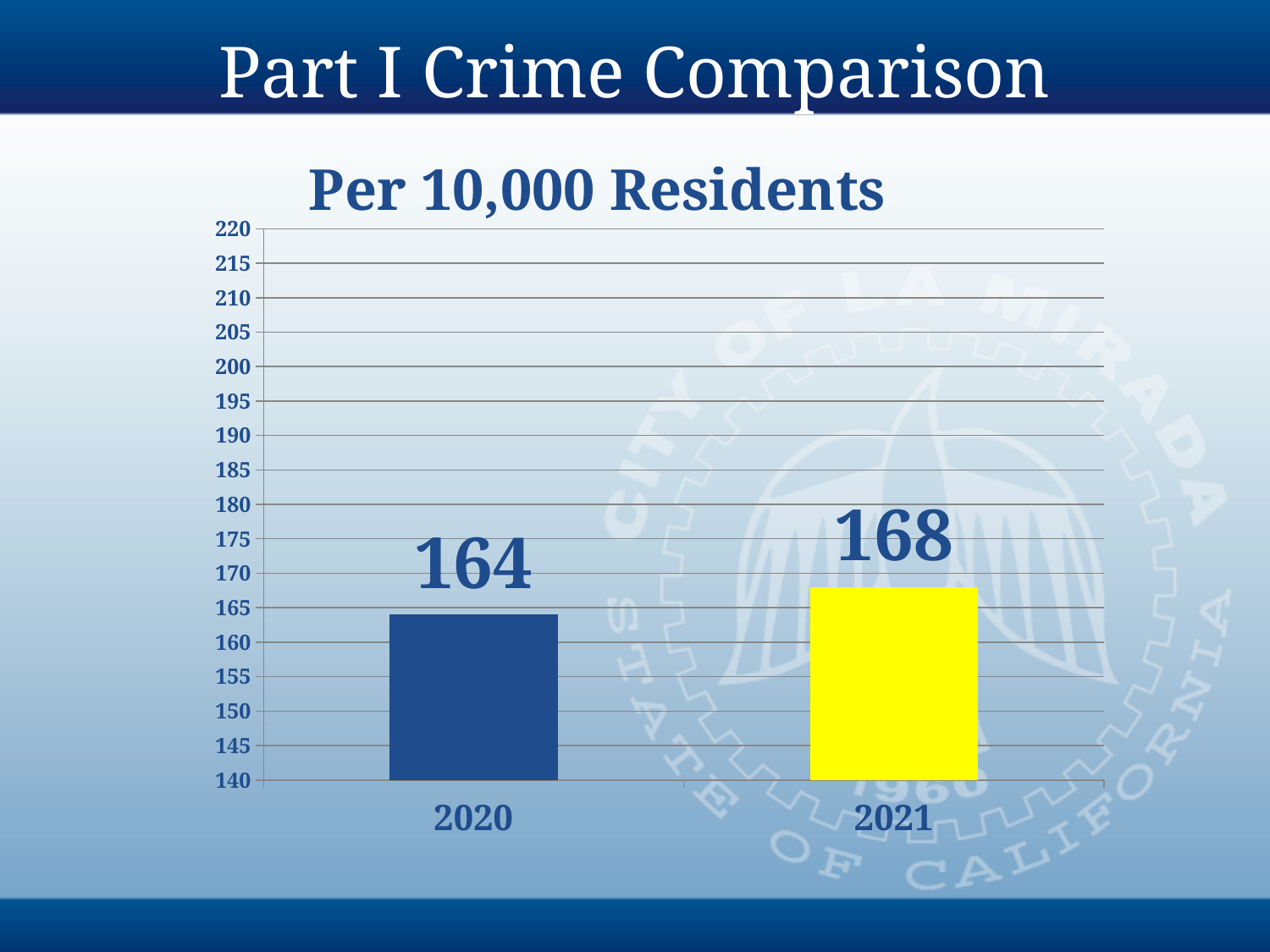
Which year has the lower value? 2020 How many years are shown on the chart? 2 Which year has the higher value? 2021 Is the value for 2021 greater or less than 165? greater What is the difference between the 2021 and 2020 values? 4 Do the values rise or fall from 2020 to 2021? Rise What is the value for 2021? 168 Is the value for 2020 greater or less than 170? less What is the title of the chart? Per 10,000 Residents What kind of chart is shown? Bar chart Is the value for 2021 larger than the value for 2020? Yes What is the value for 2020? 164